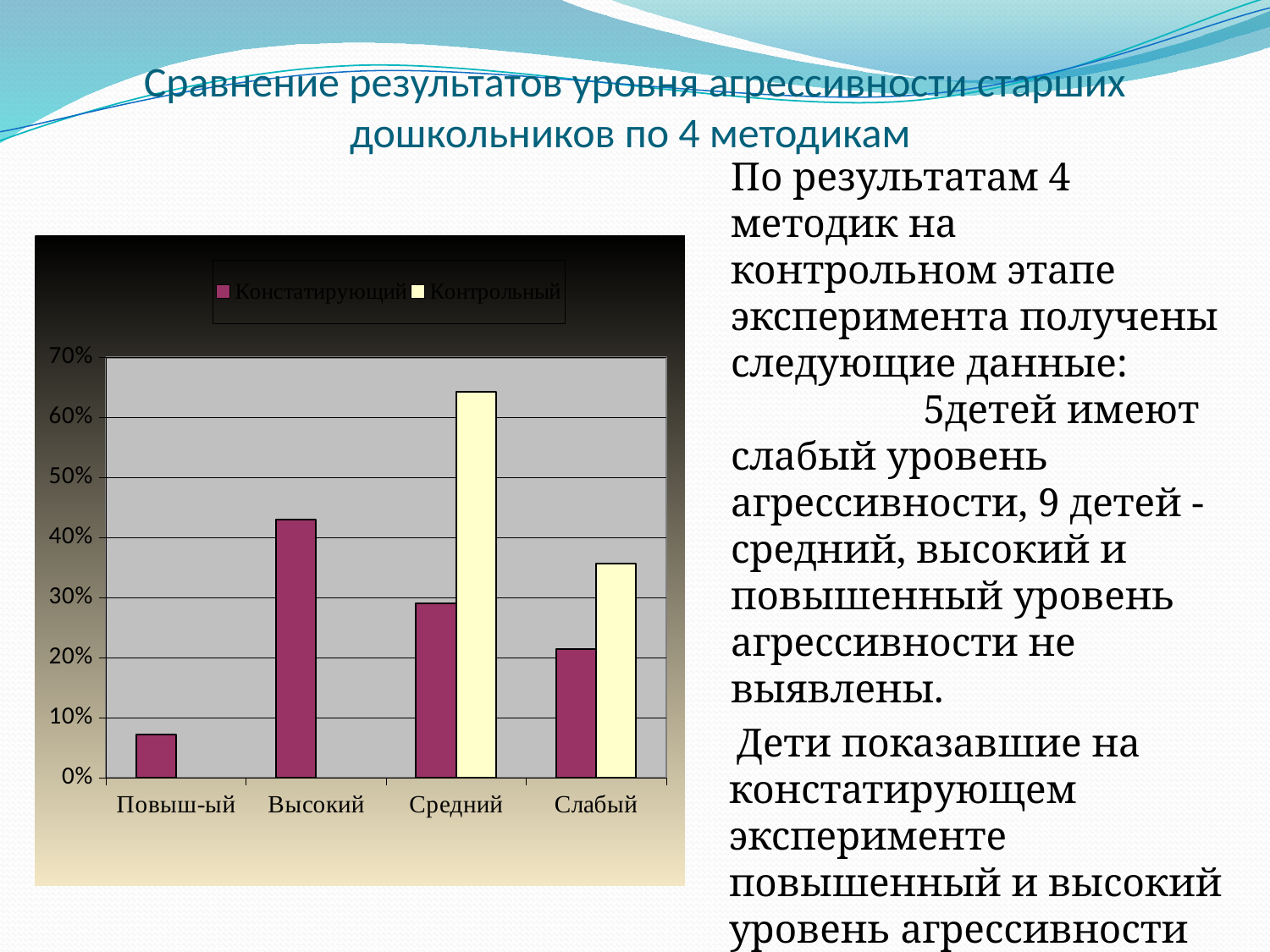
Is the Констатирующий value for Повыш-ый greater or less than 10%? less How many categories are shown on the x axis of the chart? 4 Which series is shown in yellow in the chart? Контрольный Is the Констатирующий value for Высокий greater or less than 40%? greater For the Слабый category, which series has the larger value, Констатирующий or Контрольный? Контрольный How many series does the chart's legend list? 2 What kind of chart is shown on the slide? bar chart Which category has the highest value for the Контрольный series? Средний Which category has the highest value for the Констатирующий series? Высокий Is the Контрольный value for Средний greater or less than 60%? greater What is the first entry listed in the chart's legend? Констатирующий Which category has the lowest value for the Констатирующий series? Повыш-ый